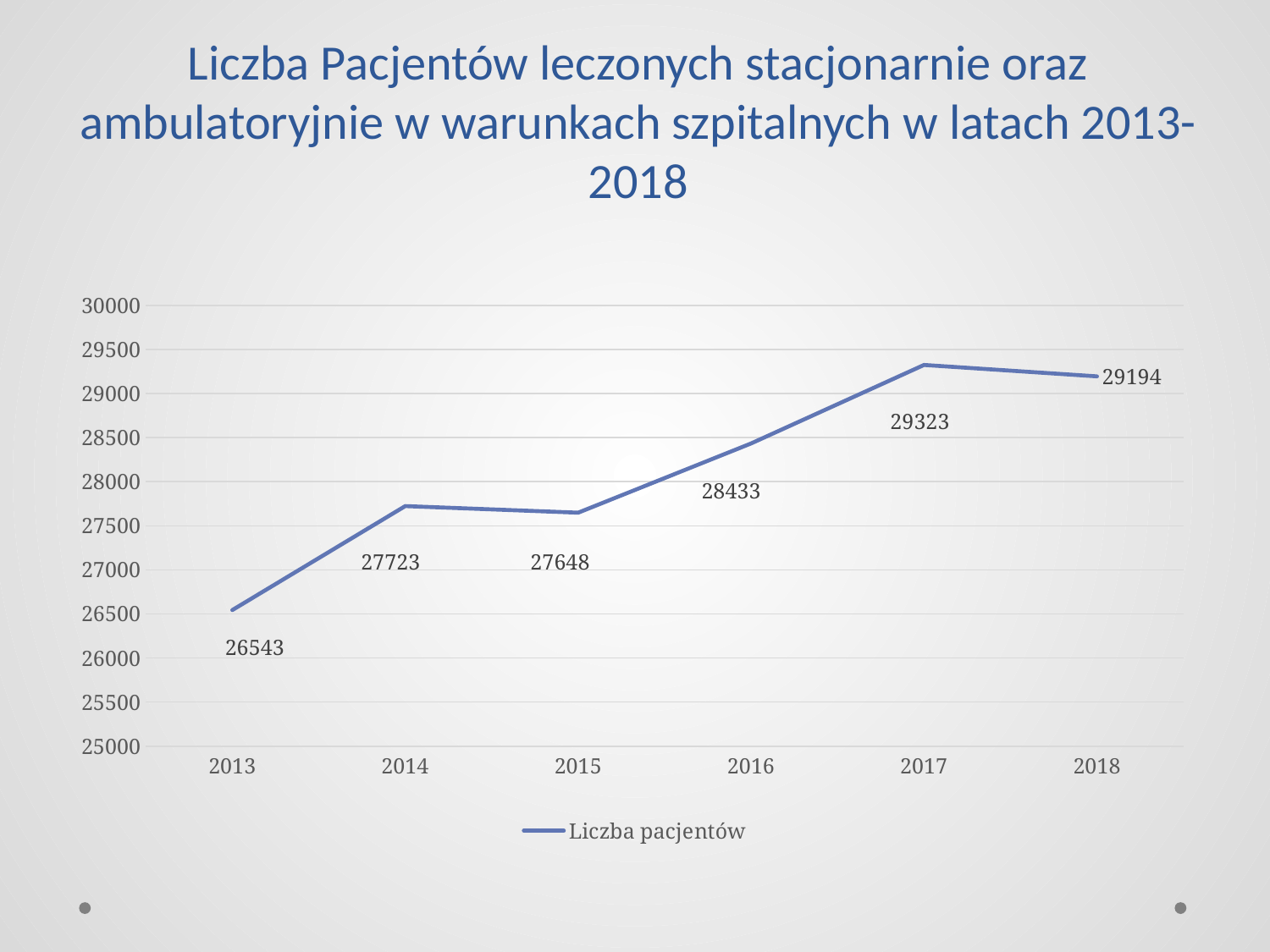
What is the number of patients in 2016? 28433 Is the number of patients in 2015 greater or less than 28000? less What is the name of the series shown in the legend? Liczba pacjentów What is the difference between the number of patients in 2017 and in 2013? 2780 How many years are shown on the x axis? 6 What is the difference between the number of patients in 2014 and in 2015? 75 Which year has the lowest number of patients? 2013 What is the number of patients in 2013? 26543 What kind of chart is shown on the slide? line chart What is the number of patients in 2018? 29194 Which year has the highest number of patients? 2017 Which year has more patients, 2016 or 2018? 2018